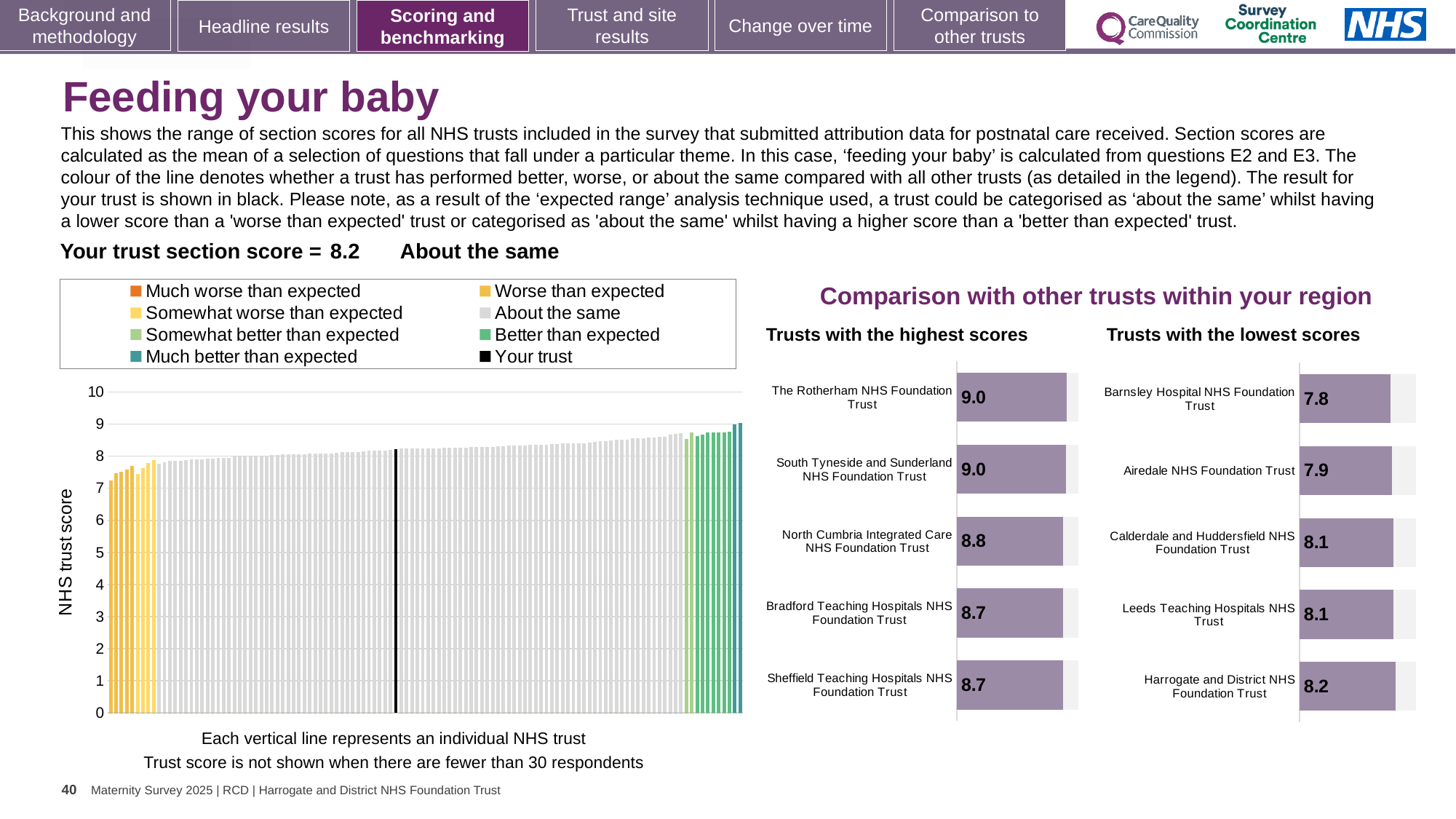
In the 'Trusts with the highest scores' chart, what is the score for The Rotherham NHS Foundation Trust? 9.0 In the 'Trusts with the highest scores' chart, what is the score for North Cumbria Integrated Care NHS Foundation Trust? 8.8 How many entries does the legend of the large chart on the left list? 8 In the 'Trusts with the lowest scores' chart, which trust has the lowest score? Barnsley Hospital NHS Foundation Trust In the 'Trusts with the lowest scores' chart, what is the score for Barnsley Hospital NHS Foundation Trust? 7.8 In the 'Trusts with the lowest scores' chart, how much higher is the score for Harrogate and District NHS Foundation Trust than for Barnsley Hospital NHS Foundation Trust? 0.4 In the 'Trusts with the lowest scores' chart, which has the higher score: Airedale NHS Foundation Trust or Calderdale and Huddersfield NHS Foundation Trust? Calderdale and Huddersfield NHS Foundation Trust What type of chart is the large chart on the left showing NHS trust scores? Bar chart How many trusts are shown in the 'Trusts with the highest scores' chart? 5 In the 'Trusts with the lowest scores' chart, what is the score for Harrogate and District NHS Foundation Trust? 8.2 In the large chart on the left, do the trust scores rise or fall from left to right? Rise In the 'Trusts with the highest scores' chart, what is the difference between the scores of The Rotherham NHS Foundation Trust and Sheffield Teaching Hospitals NHS Foundation Trust? 0.3